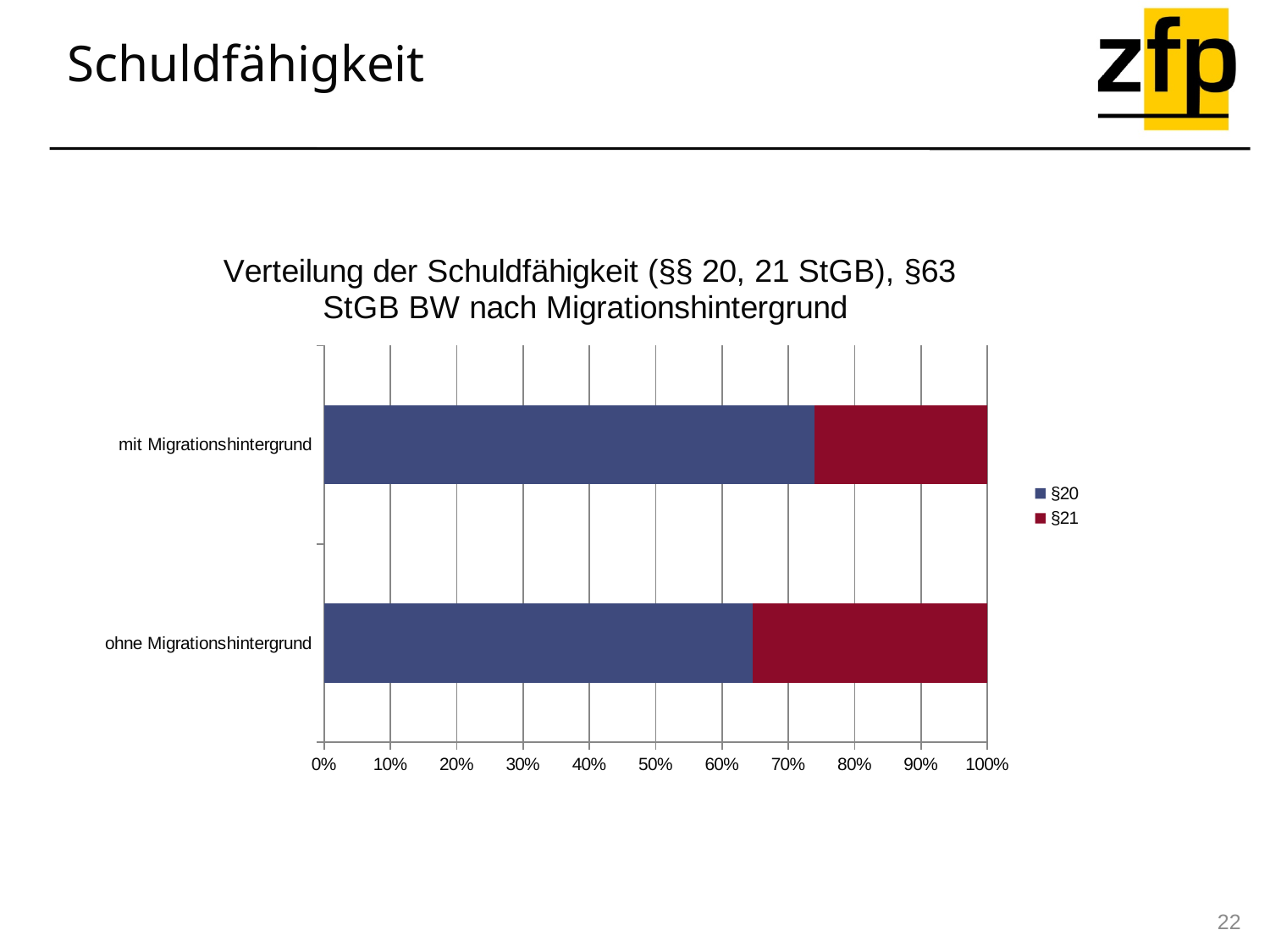
Is the §21 share for 'mit Migrationshintergrund' greater or less than 30%? less Is the §21 share for 'ohne Migrationshintergrund' greater or less than 30%? greater Is the §20 share for 'ohne Migrationshintergrund' greater or less than 60%? greater Which category has the larger §21 share: 'mit Migrationshintergrund' or 'ohne Migrationshintergrund'? ohne Migrationshintergrund What is the title of the chart? Verteilung der Schuldfähigkeit (§§ 20, 21 StGB), §63 StGB BW nach Migrationshintergrund Which series are listed in the chart's legend? §20 and §21 How many series does the chart's legend list? 2 Which category has the larger §20 share: 'mit Migrationshintergrund' or 'ohne Migrationshintergrund'? mit Migrationshintergrund How many categories are shown on the vertical axis of the chart? 2 What kind of chart is shown on the slide? bar chart